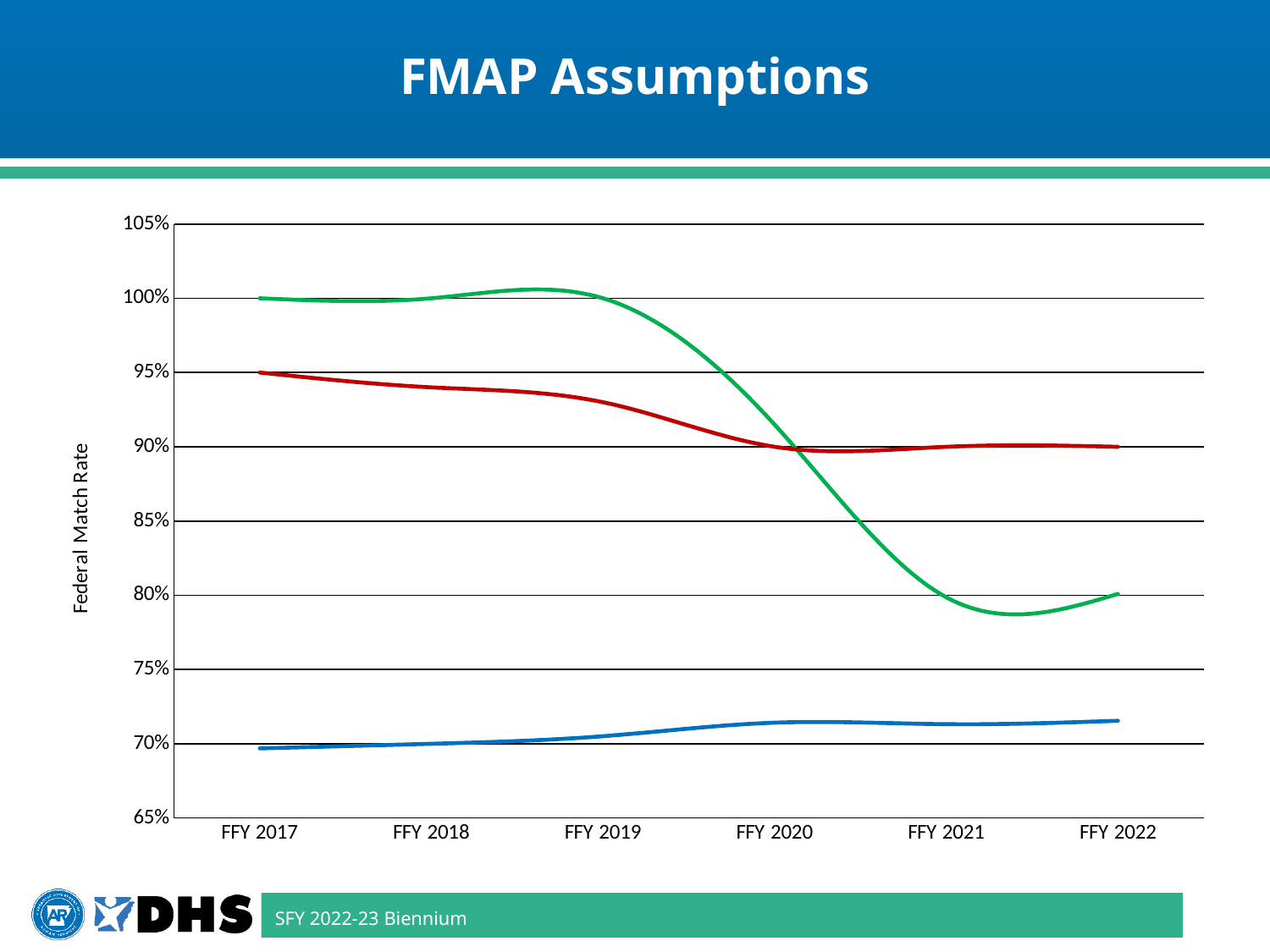
At FFY 2022, which line has the larger value, the red line or the green line? Red line How many lines are plotted on the chart? 3 What is the label of the vertical axis? Federal Match Rate How many fiscal years are shown on the x axis of the chart? 6 Does the green line rise or fall from FFY 2017 to FFY 2022? Fall Is the value of the blue line at FFY 2022 greater or less than 75%? less What is the value of the red line at FFY 2017? 95% What is the value of the red line at FFY 2022? 90% What type of chart is shown on the slide? Line chart What is the value of the green line at FFY 2017? 100% Which line has the lowest value at FFY 2022? Blue line